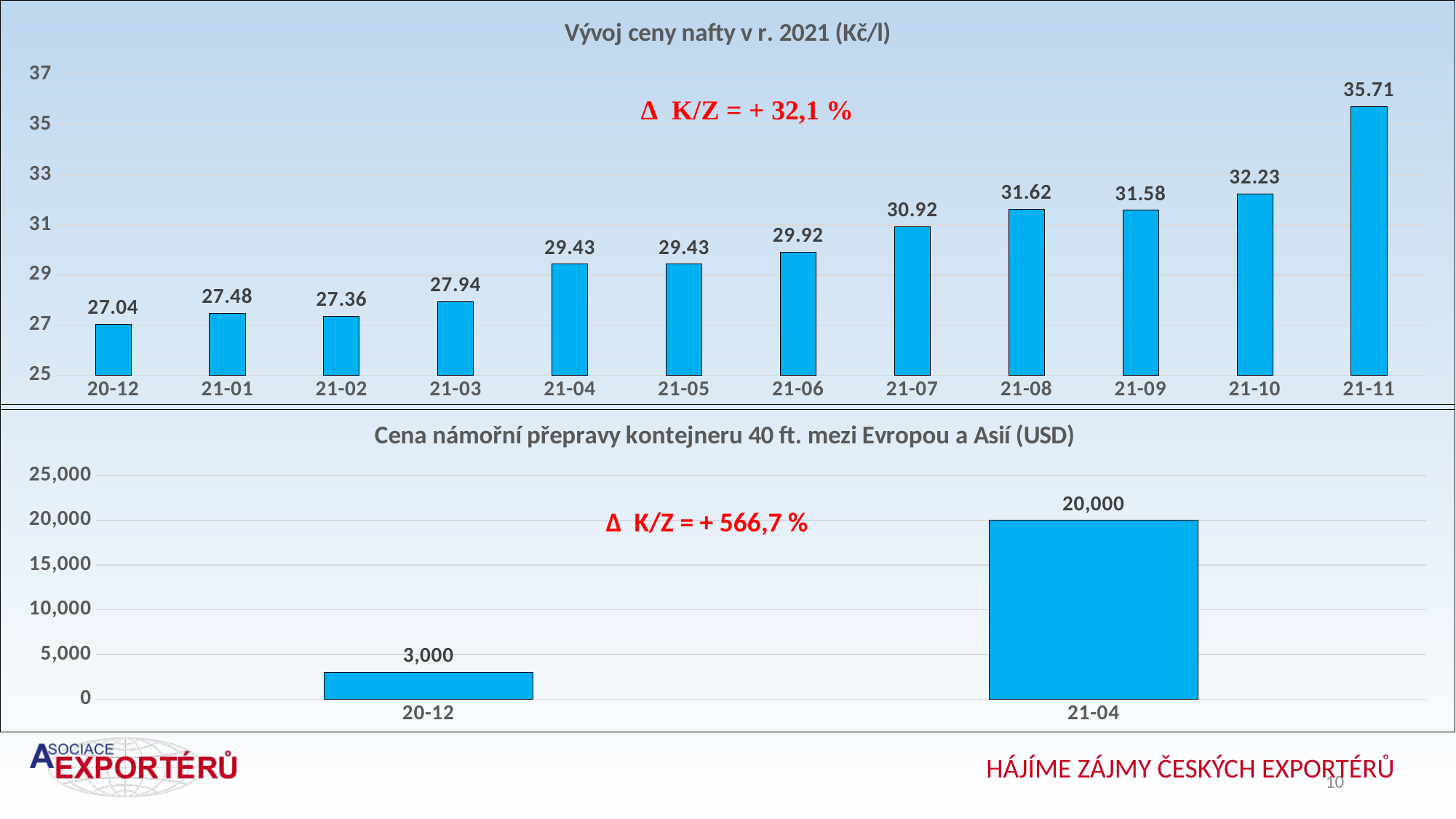
In the chart 'Vývoj ceny nafty v r. 2021 (Kč/l)', what is the value for 21-11? 35.71 In the chart 'Vývoj ceny nafty v r. 2021 (Kč/l)', what is the difference between the values for 21-11 and 20-12? 8.67 What kind of chart is the bottom chart on the slide? bar chart In the chart 'Cena námořní přepravy kontejneru 40 ft. mezi Evropou a Asií (USD)', what is the difference between the values for 21-04 and 20-12? 17,000 In the chart 'Cena námořní přepravy kontejneru 40 ft. mezi Evropou a Asií (USD)', what is the value for 21-04? 20,000 What percentage change is printed in red on the top chart? + 32,1 % In the chart 'Vývoj ceny nafty v r. 2021 (Kč/l)', how many months are plotted? 12 In the chart 'Vývoj ceny nafty v r. 2021 (Kč/l)', do the values generally rise or fall from 20-12 to 21-11? rise In the chart 'Vývoj ceny nafty v r. 2021 (Kč/l)', which month has the lowest value? 20-12 In the chart 'Vývoj ceny nafty v r. 2021 (Kč/l)', what is the value for 20-12? 27.04 In the chart 'Vývoj ceny nafty v r. 2021 (Kč/l)', which is larger, the value for 21-08 or the value for 21-09? 21-08 In the chart 'Vývoj ceny nafty v r. 2021 (Kč/l)', which month has the highest value? 21-11